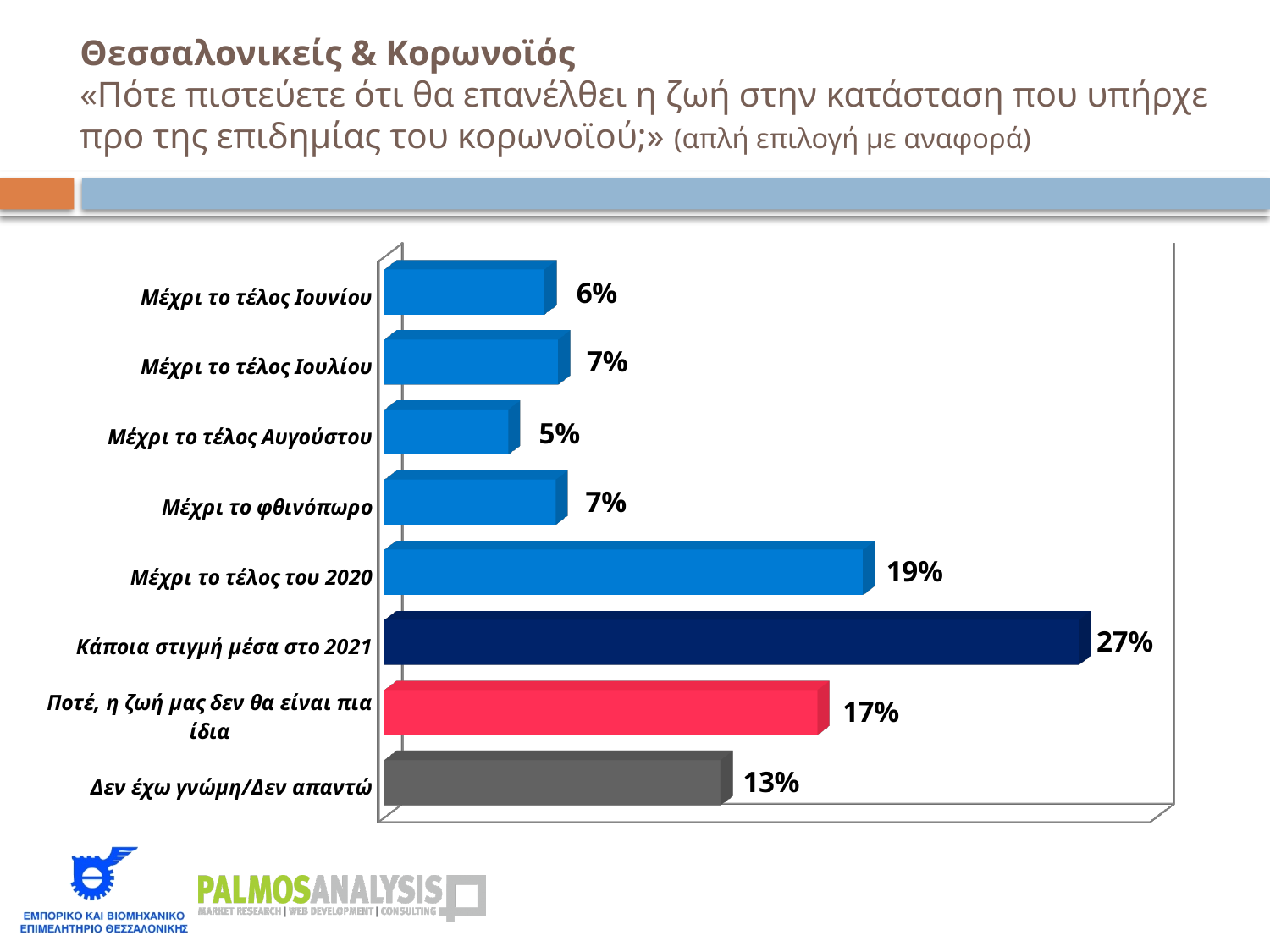
Which is larger: "Ποτέ, η ζωή μας δεν θα είναι πια ίδια" or "Δεν έχω γνώμη/Δεν απαντώ"? Ποτέ, η ζωή μας δεν θα είναι πια ίδια What percentage of respondents chose "Κάποια στιγμή μέσα στο 2021"? 27% Which category has the lowest value? Μέχρι το τέλος Αυγούστου What is the value for "Δεν έχω γνώμη/Δεν απαντώ"? 13% What is the value for "Μέχρι το τέλος του 2020"? 19% What percentage answered "Ποτέ, η ζωή μας δεν θα είναι πια ίδια"? 17% Which category has the highest value? Κάποια στιγμή μέσα στο 2021 What is the difference between "Μέχρι το τέλος Ιουλίου" and "Μέχρι το τέλος Ιουνίου"? 1 percentage point What kind of chart is shown on the slide? Bar chart What colour is the bar for "Ποτέ, η ζωή μας δεν θα είναι πια ίδια"? Red What is the difference between "Κάποια στιγμή μέσα στο 2021" and "Μέχρι το τέλος του 2020"? 8 percentage points How many categories are shown in the chart? 8